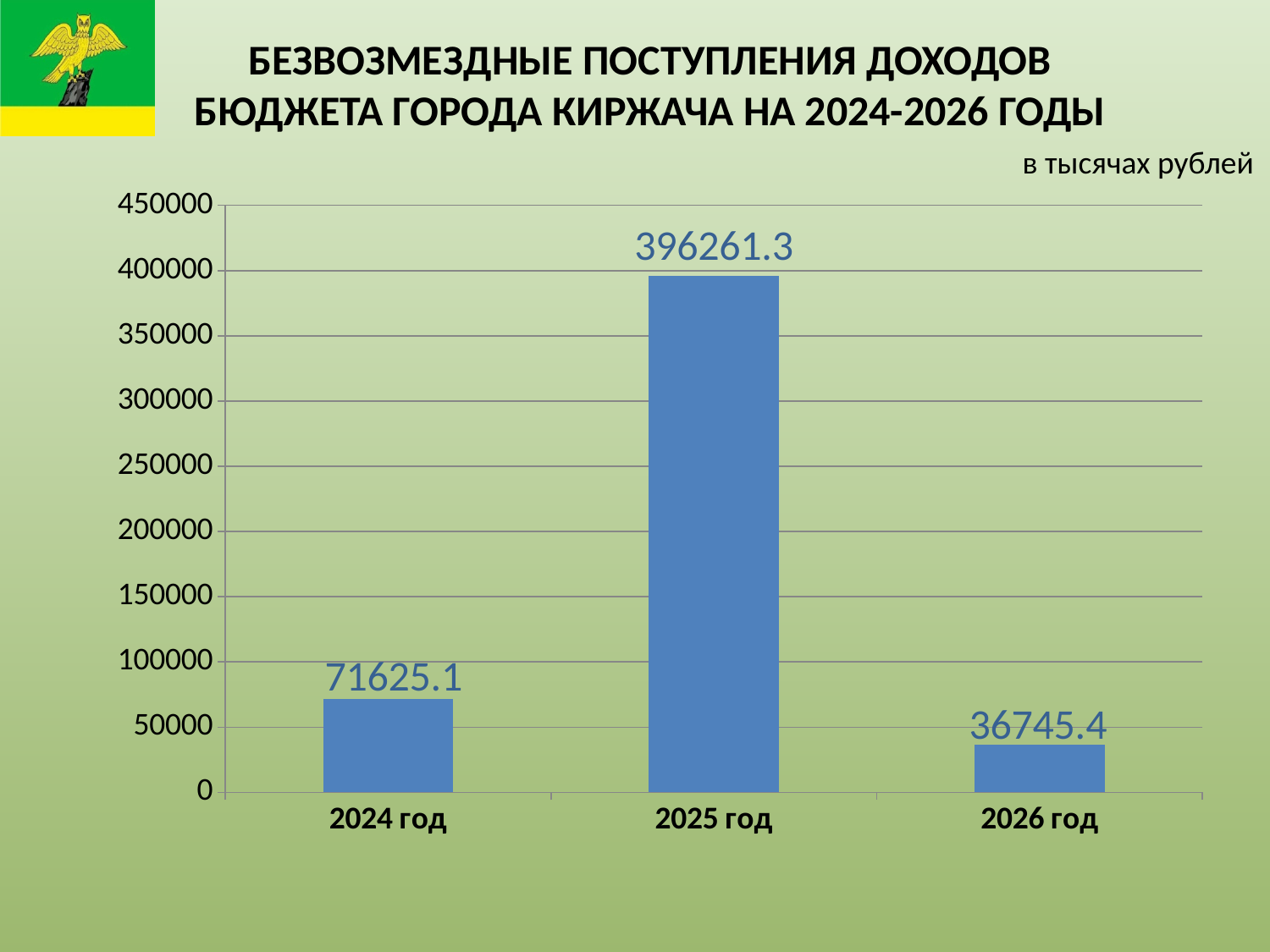
What is the value for 2026 год? 36745.4 Which year has the lowest value? 2026 год Which is larger, the value for 2024 год or the value for 2026 год? 2024 год What is the difference between the values for 2025 год and 2024 год? 324636.2 What kind of chart is shown on the slide? bar chart In what units are the values on the chart given? в тысячах рублей What is the value for 2025 год? 396261.3 What is the difference between the values for 2024 год and 2026 год? 34879.7 What is the value for 2024 год? 71625.1 Which year has the highest value? 2025 год Is the value for 2025 год greater or less than 350000? greater How many years are shown on the x axis? 3